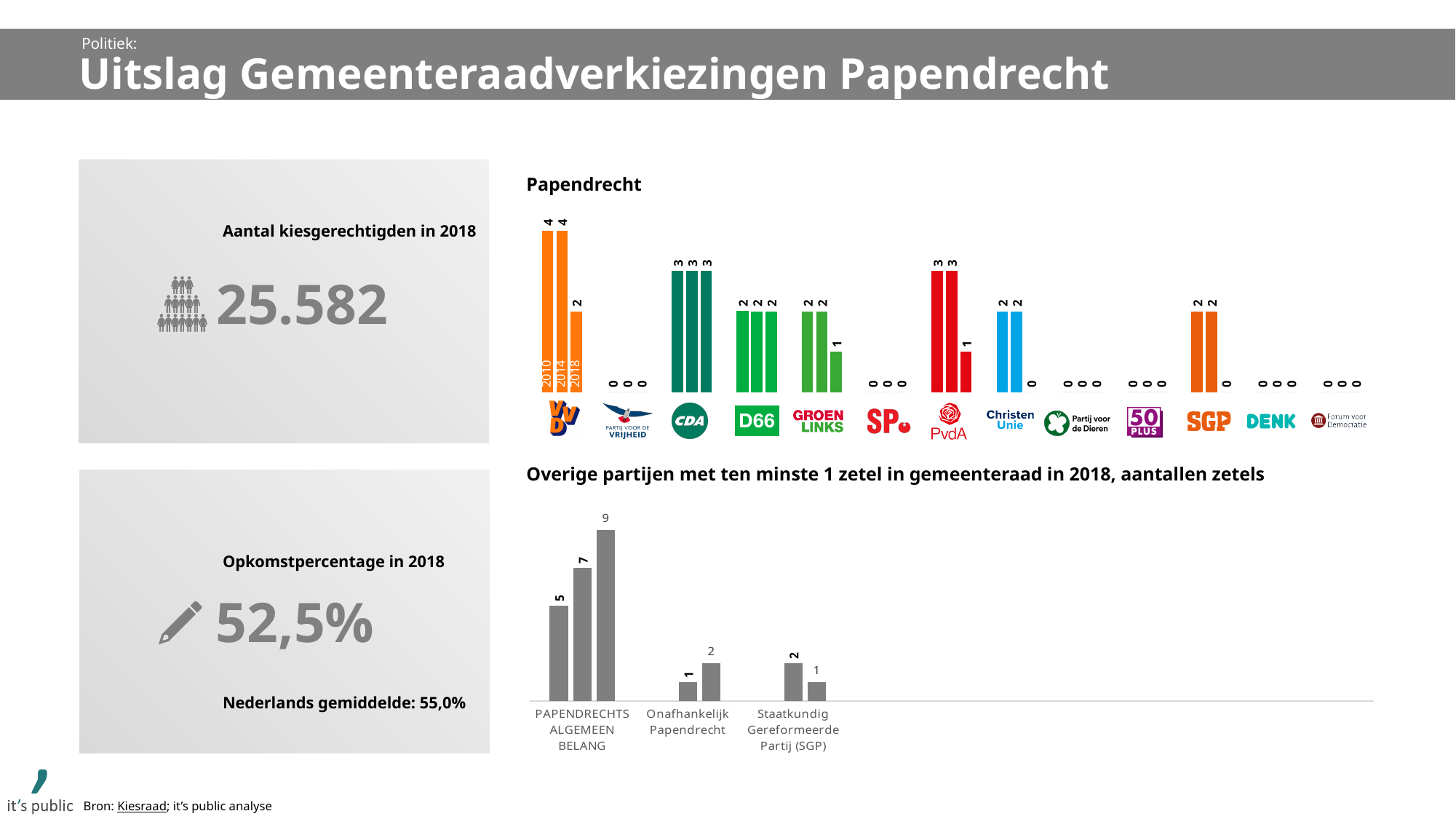
In the chart 'Overige partijen met ten minste 1 zetel in gemeenteraad in 2018', what is the highest number of seats shown for Papendrechts Algemeen Belang? 9 In the chart 'Overige partijen met ten minste 1 zetel in gemeenteraad in 2018', what is the difference between the highest and lowest bar for Papendrechts Algemeen Belang? 4 In the Papendrecht chart, how many seats did the CDA have in 2018? 3 In the Papendrecht chart, what is the difference between the VVD's seats in 2014 and in 2018? 2 In the Papendrecht chart, how many seats did the ChristenUnie have in 2018? 0 What kind of chart is the 'Overige partijen met ten minste 1 zetel in gemeenteraad in 2018' chart? bar chart How many parties are shown along the x axis of the Papendrecht chart? 13 In the Papendrecht chart, which party had more seats in 2018, the CDA or the PvdA? CDA In the Papendrecht chart, how many seats did the VVD win in 2018? 2 In the Papendrecht chart, do the VVD's seats rise or fall from 2010 to 2018? fall In the chart 'Overige partijen met ten minste 1 zetel in gemeenteraad in 2018', how many parties are shown? 3 In the Papendrecht chart, how many seats did the PvdA have in 2018? 1